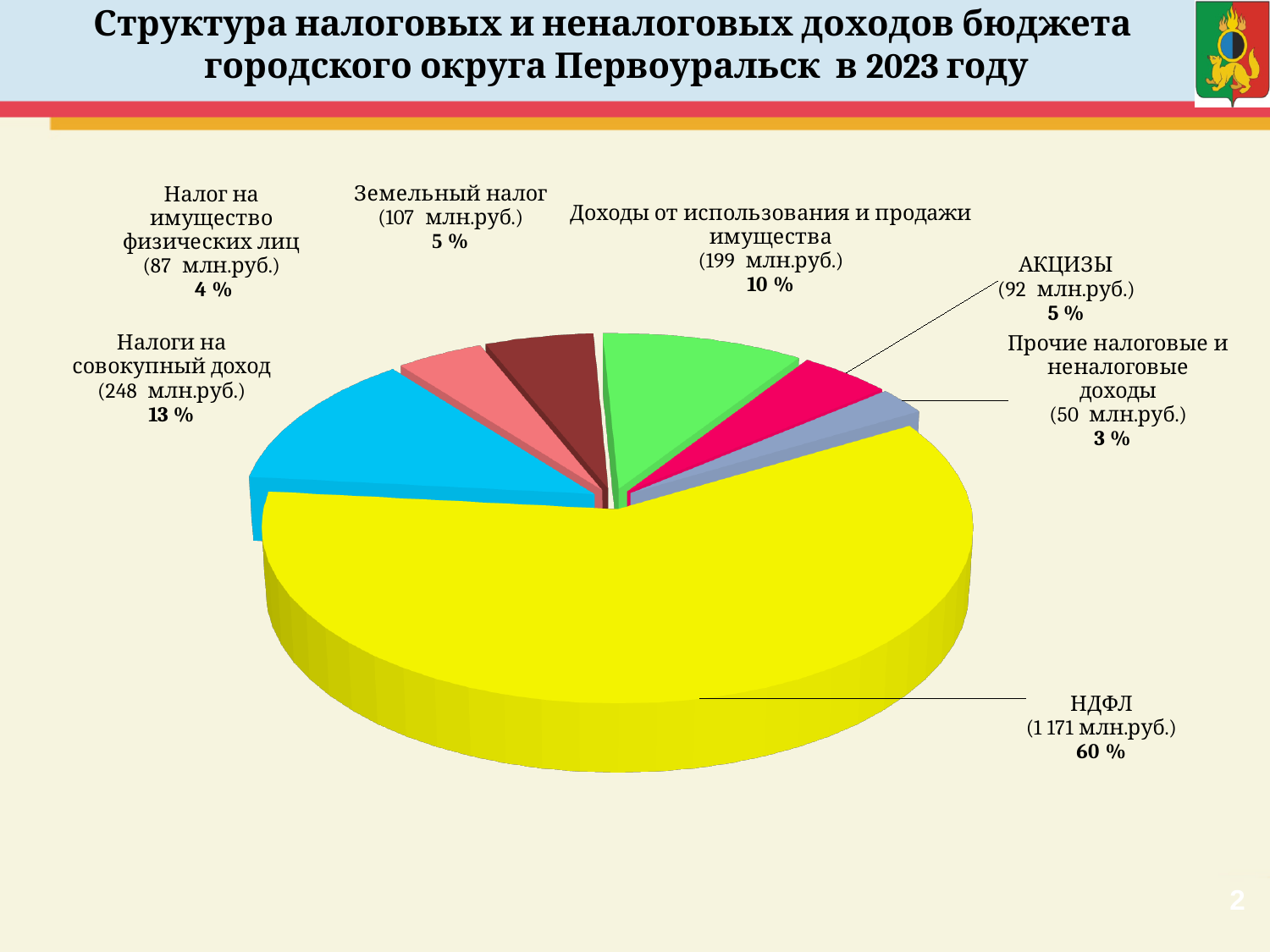
What colour is the НДФЛ slice? yellow Which category has the largest slice of the pie? НДФЛ What is the value shown for Прочие налоговые и неналоговые доходы? 50 млн.руб. What is the difference in млн.руб. between Земельный налог and АКЦИЗЫ? 15 млн.руб. What share of the pie does НДФЛ represent? 60 % Which is larger: Налог на имущество физических лиц or Налоги на совокупный доход? Налоги на совокупный доход How many slices does the pie chart have? 7 What type of chart is shown on the slide? pie chart Which category has the smallest slice of the pie? Прочие налоговые и неналоговые доходы What is the value shown for Налоги на совокупный доход? 248 млн.руб. What percentage is shown for Доходы от использования и продажи имущества? 10 % What is the value shown for НДФЛ? 1 171 млн.руб.